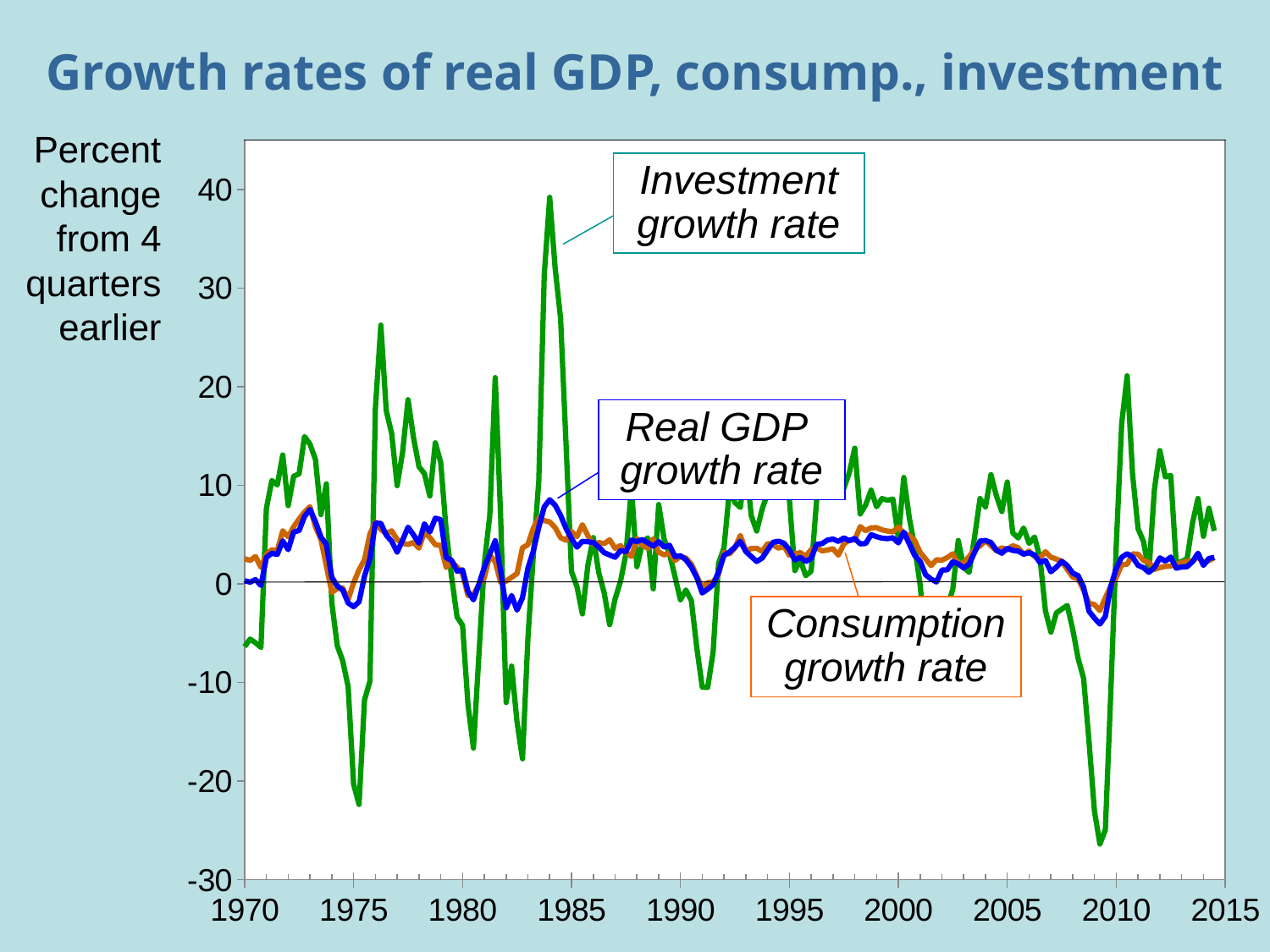
Is the investment growth rate around 1975 greater or less than -10? less Is the peak value of the investment growth rate around 1984 greater or less than 30? greater How many data series are plotted on the chart? 3 Around 1984, which is larger: the investment growth rate or the real GDP growth rate? Investment growth rate Is the real GDP growth rate at its 1984 peak greater or less than 10? less What is the first year shown on the x axis? 1970 Which series reaches the lowest value on the chart? Investment growth rate Which series reaches the highest value on the chart? Investment growth rate Which series is drawn in green? Investment growth rate What kind of chart is shown on the slide? line chart What is the title of the chart? Growth rates of real GDP, consump., investment